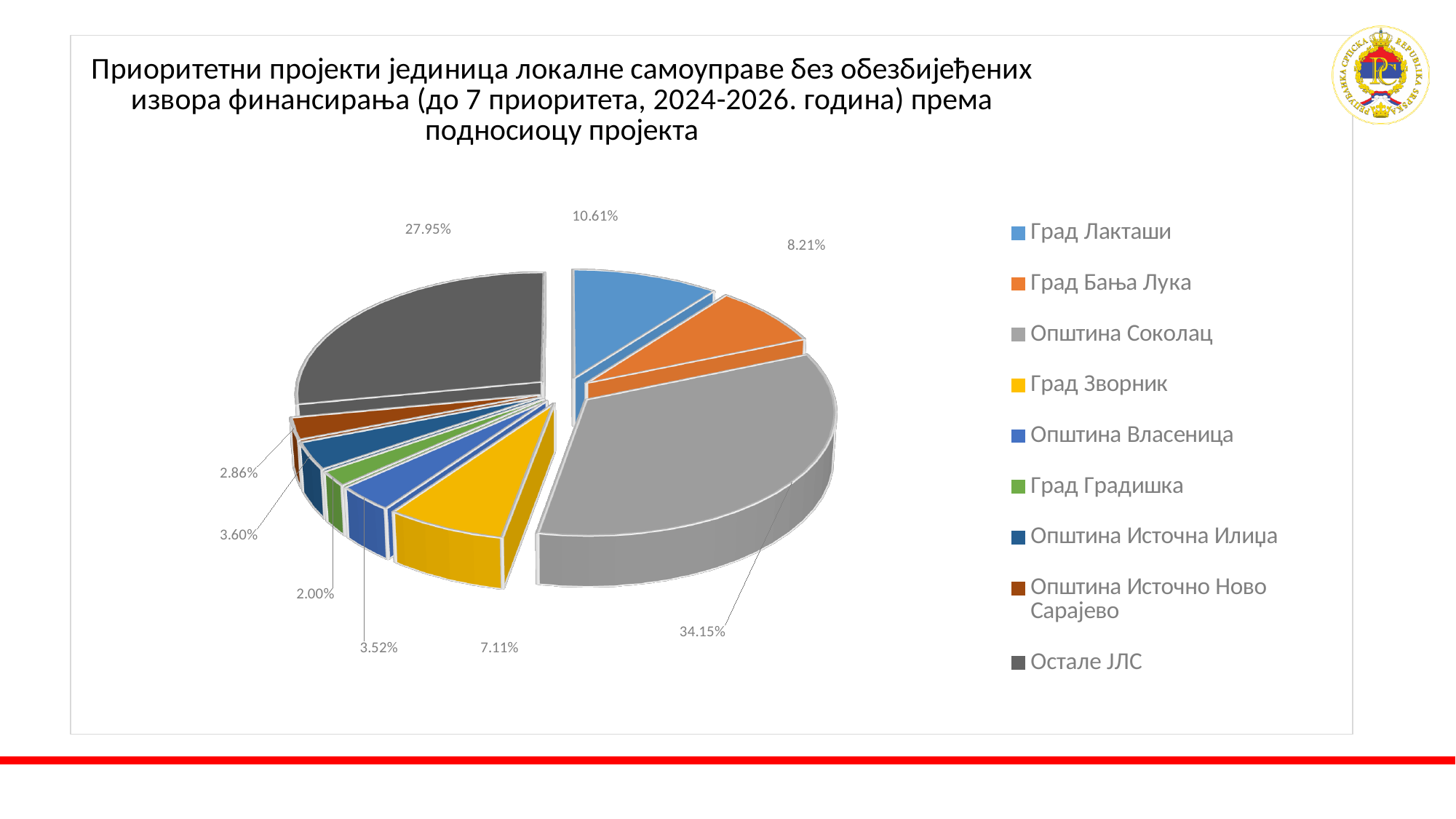
What is the value for Остале ЈЛС? 27.95% How many categories does the pie chart show? 9 What kind of chart is shown on the slide? Pie chart Which is larger, the share for Град Лакташи or the share for Град Бања Лука? Град Лакташи What is the difference between the shares of Општина Соколац and Остале ЈЛС? 6.20% What percentage is shown for Град Зворник? 7.11% What share of the pie does Општина Соколац hold? 34.15% Which category has the smallest slice of the pie? Град Градишка What is the combined share of Општина Власеница and Општина Источна Илиџа? 7.12% Which colour represents Град Зворник in the legend? Yellow What percentage is shown for Град Лакташи? 10.61% Which category has the largest slice of the pie? Општина Соколац